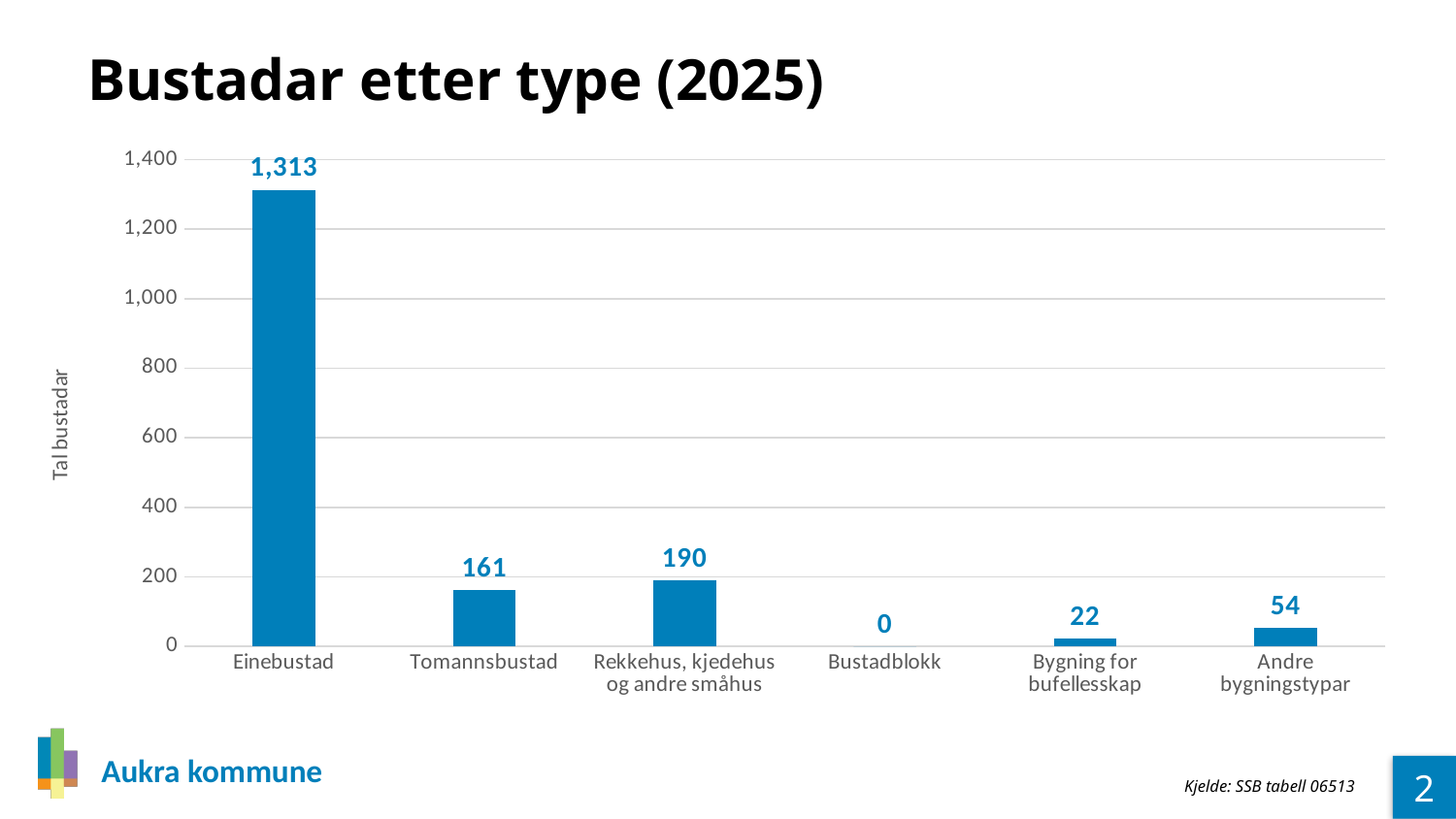
What is the value for Tomannsbustad? 161 Which is larger, the value for Andre bygningstypar or the value for Bygning for bufellesskap? Andre bygningstypar What is the difference between the values for Rekkehus, kjedehus og andre småhus and Tomannsbustad? 29 What is the title of the chart? Bustadar etter type (2025) What is the value for Einebustad? 1,313 Is the value for Einebustad greater or less than 1,200? greater What kind of chart is shown on the slide? Bar chart How many categories are shown on the x axis? 6 What is the value for Rekkehus, kjedehus og andre småhus? 190 What is the value for Bygning for bufellesskap? 22 Which category has the highest value? Einebustad Which category has the lowest value? Bustadblokk